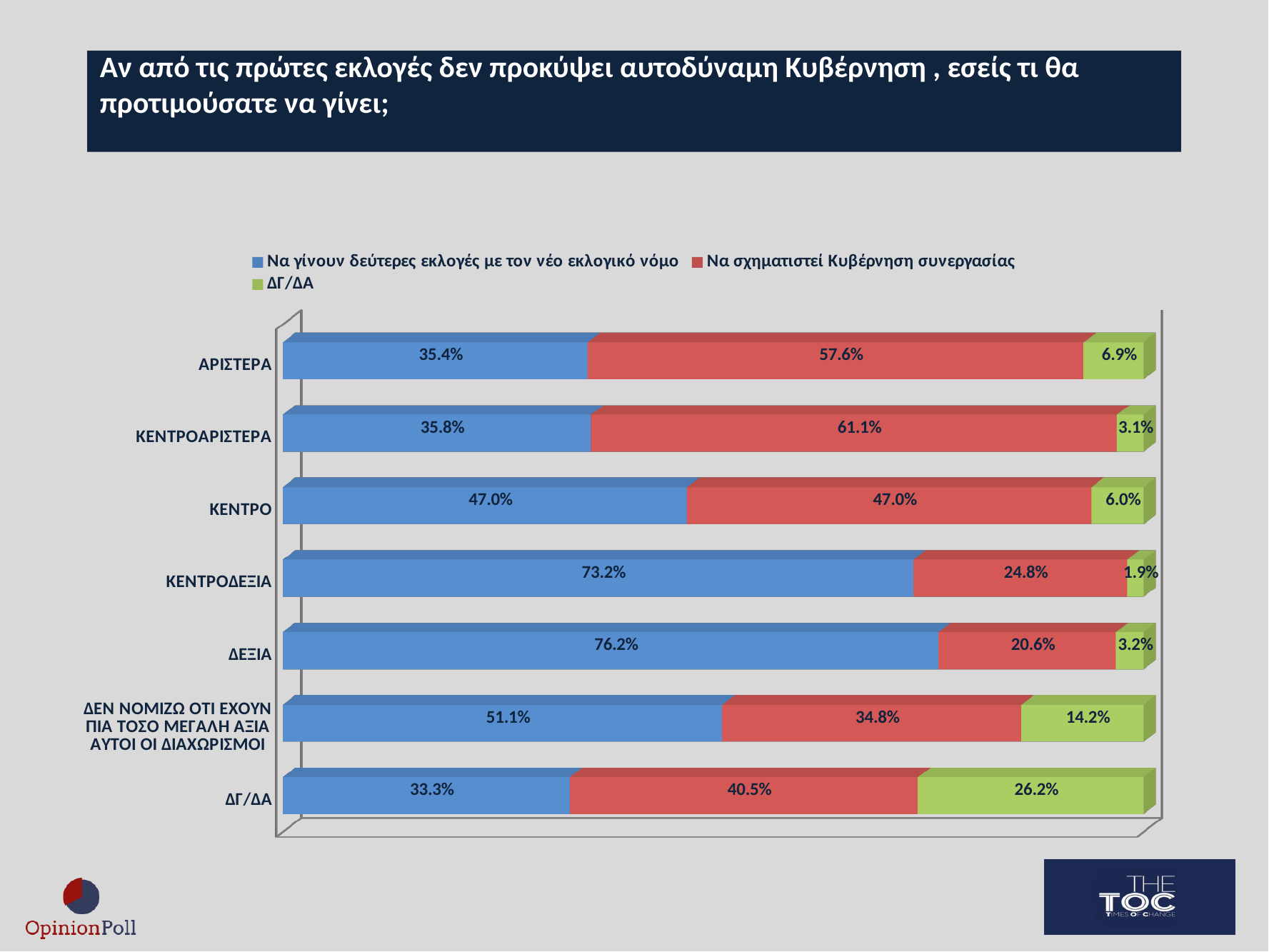
What is the value of 'Να σχηματιστεί Κυβέρνηση συνεργασίας' for ΚΕΝΤΡΟΑΡΙΣΤΕΡΑ? 61.1% Which category has the highest value for 'Να γίνουν δεύτερες εκλογές με τον νέο εκλογικό νόμο'? ΔΕΞΙΑ What type of chart is shown on the slide? Stacked bar chart Which category has the lowest ΔΓ/ΔΑ value? ΚΕΝΤΡΟΔΕΞΙΑ Which category has the lowest value for 'Να σχηματιστεί Κυβέρνηση συνεργασίας'? ΔΕΞΙΑ What colour represents the series 'Να σχηματιστεί Κυβέρνηση συνεργασίας'? Red How many series does the legend list? 3 How many categories are shown on the vertical axis? 7 What is the value of 'Να γίνουν δεύτερες εκλογές με τον νέο εκλογικό νόμο' for ΔΕΞΙΑ? 76.2% Which is larger: the 'Να σχηματιστεί Κυβέρνηση συνεργασίας' value for ΑΡΙΣΤΕΡΑ or for ΚΕΝΤΡΟΔΕΞΙΑ? ΑΡΙΣΤΕΡΑ What is the difference between the 'Να γίνουν δεύτερες εκλογές με τον νέο εκλογικό νόμο' values for ΔΕΞΙΑ and ΑΡΙΣΤΕΡΑ? 40.8% What is the ΔΓ/ΔΑ value for the category ΔΓ/ΔΑ? 26.2%